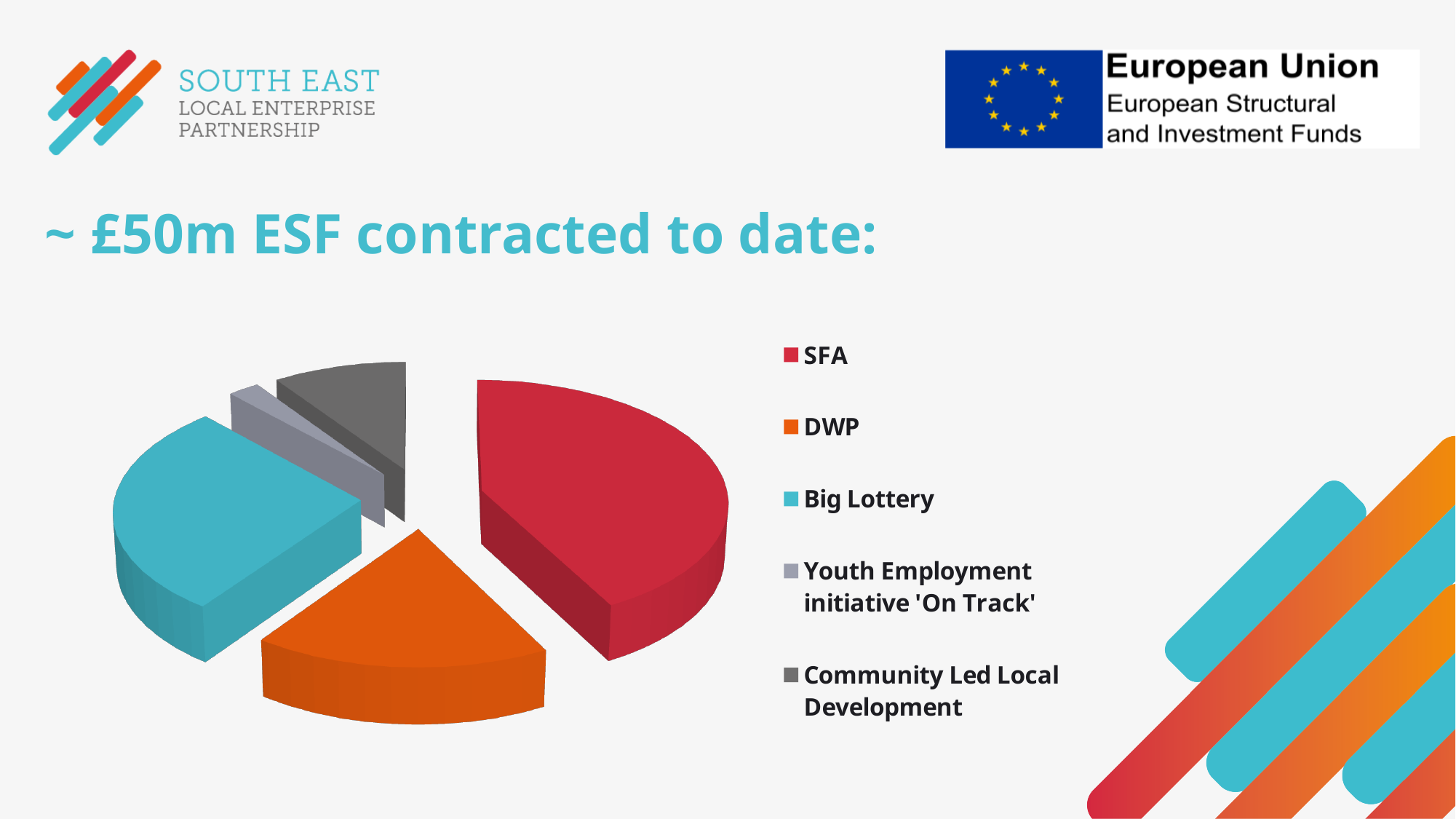
Which slice is larger in the pie chart, Big Lottery or Community Led Local Development? Big Lottery Which category has the smallest slice of the pie chart? Youth Employment initiative 'On Track' Which category has the largest slice of the pie chart? SFA Which slice is larger in the pie chart, SFA or DWP? SFA What kind of chart is shown on the slide? Pie chart Which slice is larger in the pie chart, DWP or Youth Employment initiative 'On Track'? DWP How many slices does the pie chart have? 5 What is the title shown above the pie chart? ~ £50m ESF contracted to date: How many entries does the legend of the pie chart list? 5 What colour is the SFA slice in the pie chart? Red